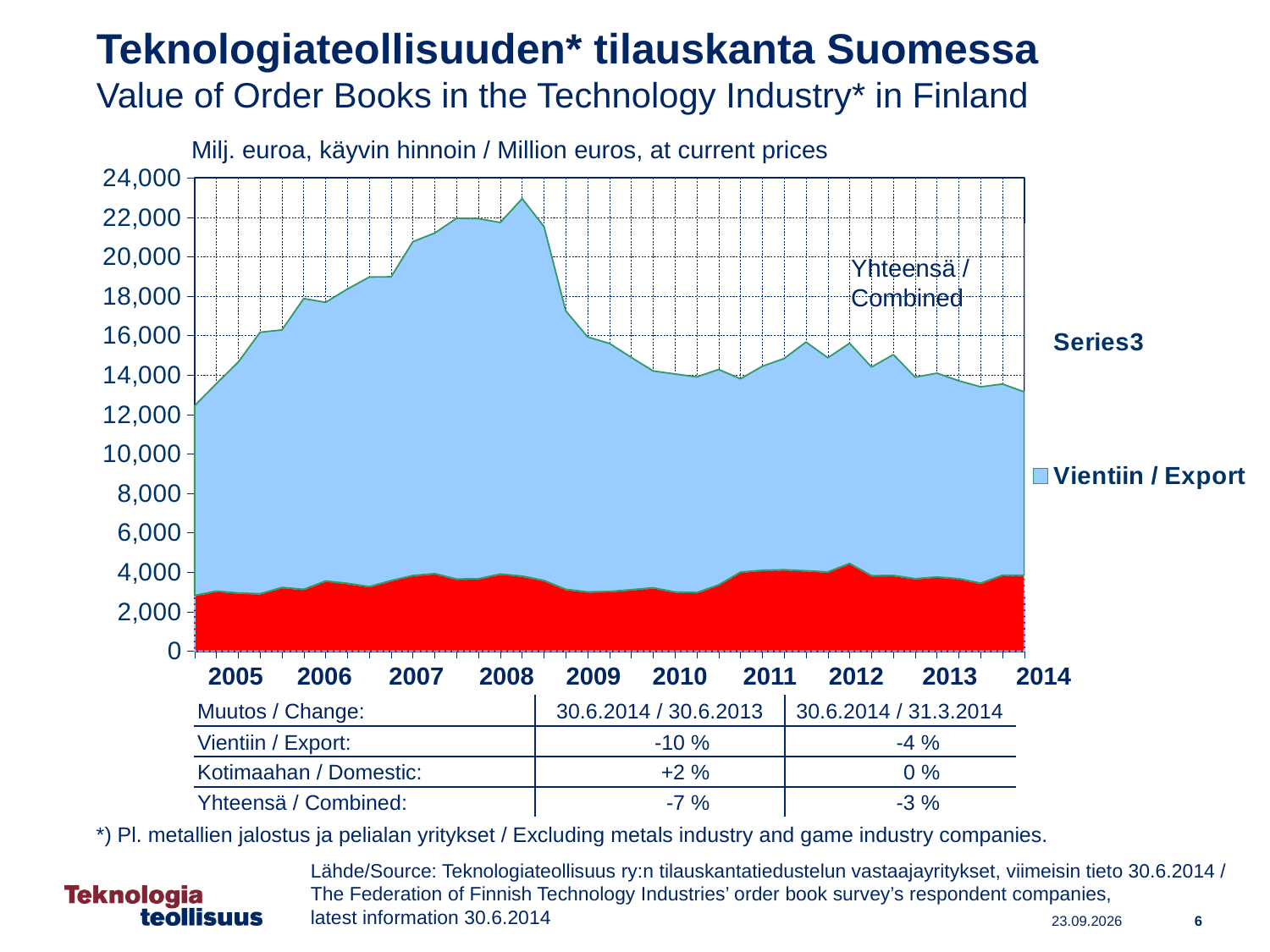
Does the combined (Yhteensä / Combined) order book value rise or fall from its 2008 peak to 2009? fall Which year shows the highest combined (Yhteensä / Combined) order book value? 2008 Does the combined (Yhteensä / Combined) order book value rise or fall from 2005 to 2008? rise How many series does the chart legend list? 2 How many year labels are shown on the x axis? 10 What unit is stated above the chart for the values? Milj. euroa, käyvin hinnoin / Million euros, at current prices Is the combined (Yhteensä / Combined) value at the end of the series in 2014 greater or less than 14,000? less What are the two entries in the chart legend? Series3 and Vientiin / Export Is the peak value of the combined (Yhteensä / Combined) order book in 2008 greater or less than 22,000? greater Is the combined (Yhteensä / Combined) value in 2009 greater or less than 20,000? less What kind of chart is shown on the slide? Area chart